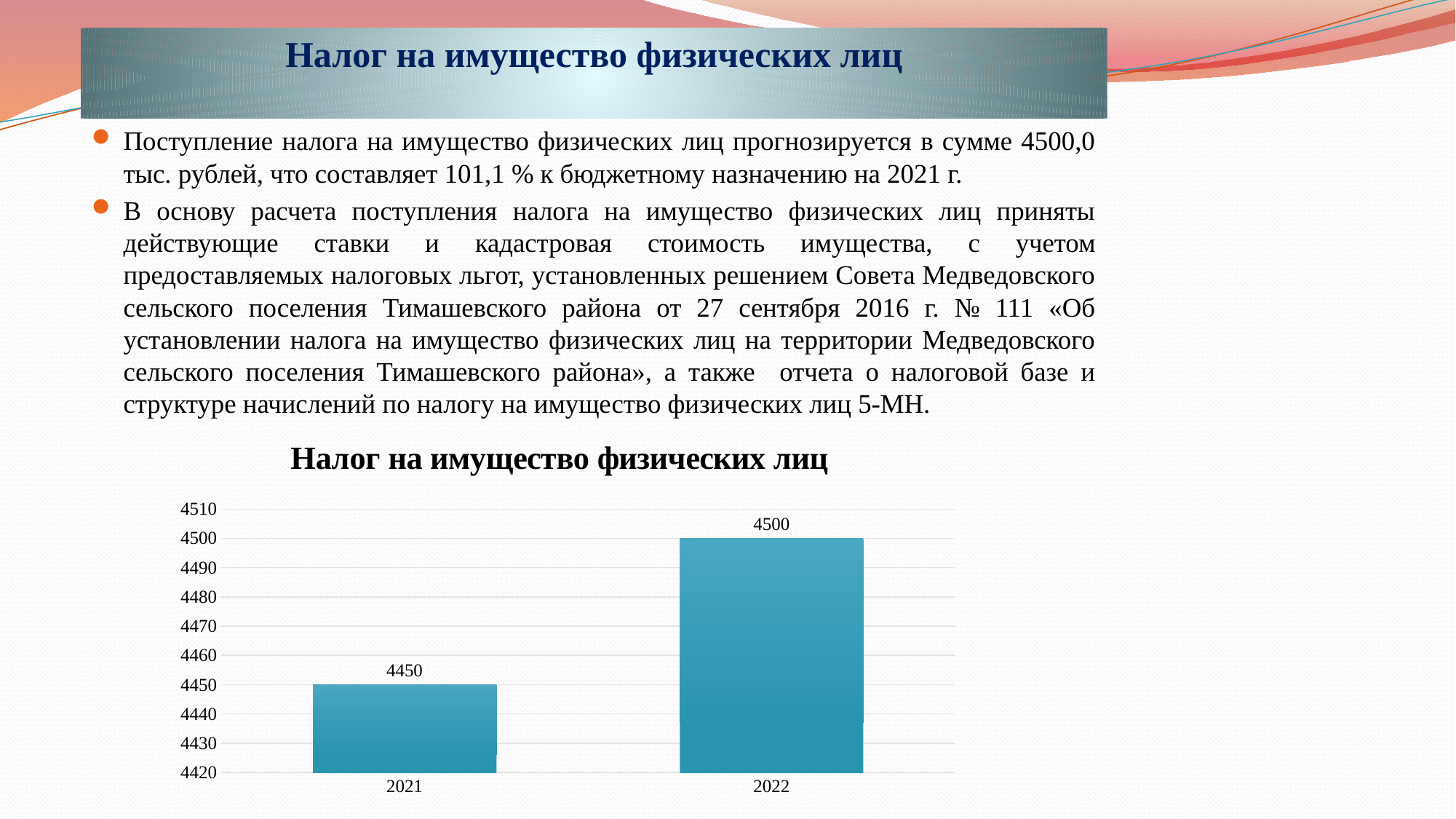
Which is larger, the value for 2021 or the value for 2022? 2022 What kind of chart is shown on the slide? bar chart What is the value for 2021 in the chart? 4450 How many categories are shown on the x axis of the chart? 2 Is the value for 2022 greater or less than 4490? greater Is the value for 2021 greater or less than 4460? less What is the title of the chart? Налог на имущество физических лиц Do the values rise or fall from 2021 to 2022? rise Which year has the lowest value in the chart? 2021 What is the value for 2022 in the chart? 4500 What is the difference between the values for 2022 and 2021? 50 Which year has the highest value in the chart? 2022